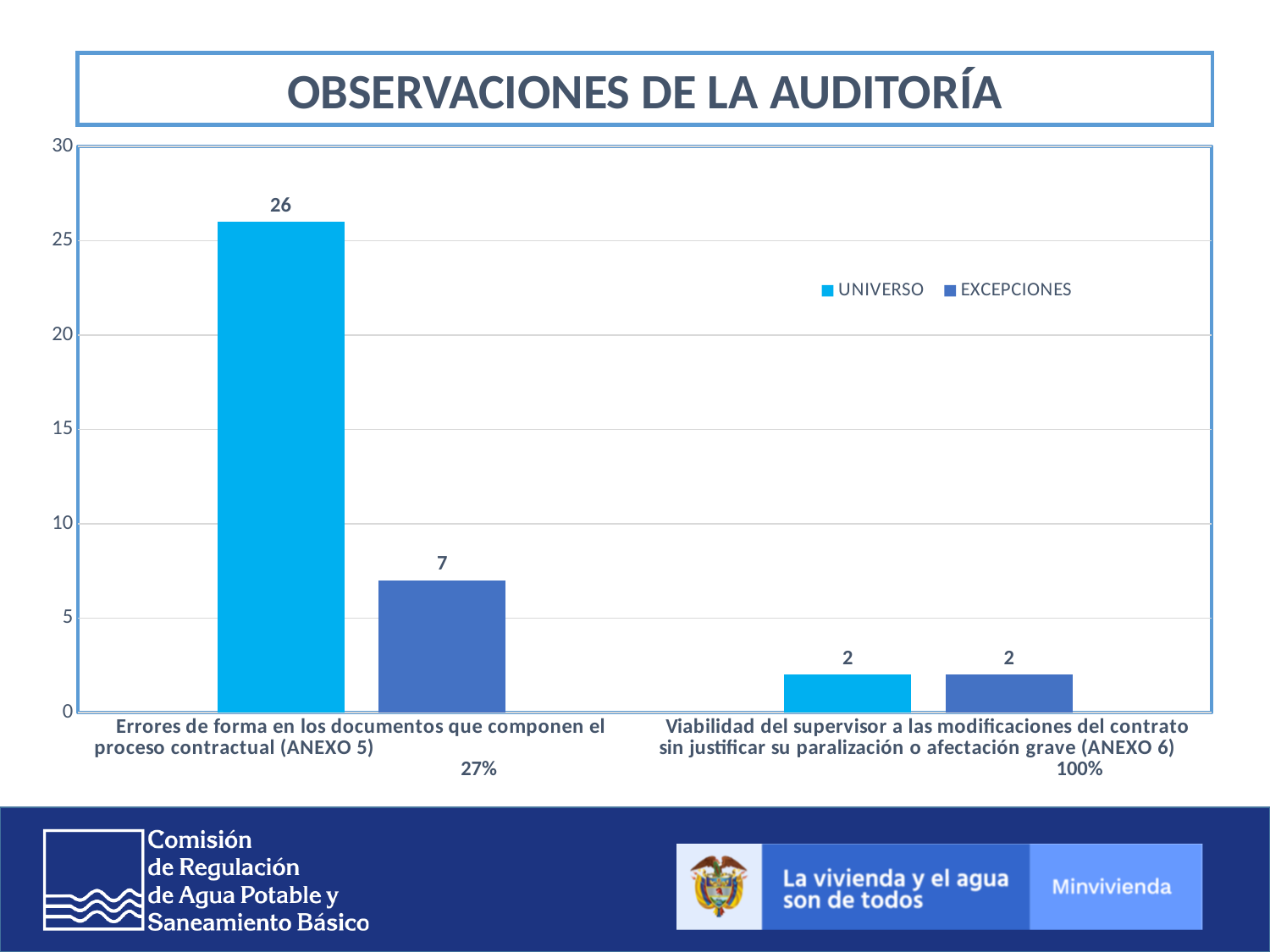
Which category has the lowest EXCEPCIONES value? Viabilidad del supervisor a las modificaciones del contrato sin justificar su paralización o afectación grave (ANEXO 6) What kind of chart is shown on the slide? Bar chart What is the title of the chart? OBSERVACIONES DE LA AUDITORÍA What is the EXCEPCIONES value for 'Errores de forma en los documentos que componen el proceso contractual (ANEXO 5)'? 7 How many series does the legend list? 2 How many categories are shown on the x axis? 2 What is the UNIVERSO value for 'Viabilidad del supervisor a las modificaciones del contrato sin justificar su paralización o afectación grave (ANEXO 6)'? 2 What is the difference between the UNIVERSO and EXCEPCIONES values for ANEXO 5? 19 Which category has the highest UNIVERSO value? Errores de forma en los documentos que componen el proceso contractual (ANEXO 5) What is the EXCEPCIONES value for 'Viabilidad del supervisor a las modificaciones del contrato sin justificar su paralización o afectación grave (ANEXO 6)'? 2 Which is larger for ANEXO 5: the UNIVERSO value or the EXCEPCIONES value? UNIVERSO What is the UNIVERSO value for 'Errores de forma en los documentos que componen el proceso contractual (ANEXO 5)'? 26